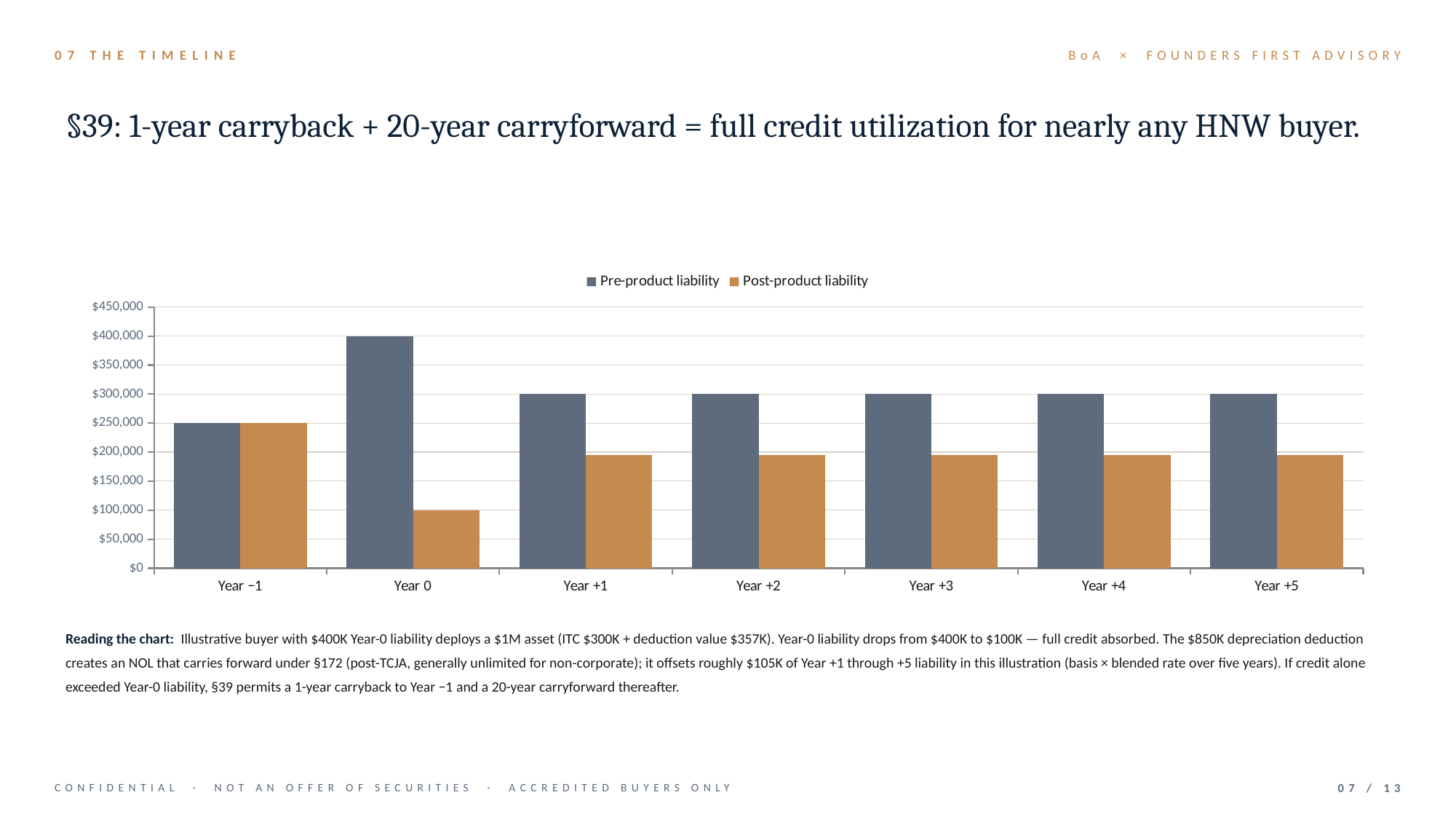
How many year categories are shown on the x axis? 7 What is the difference between Pre-product liability and Post-product liability in Year 0? $300,000 What kind of chart is shown on the slide? bar chart How many series does the legend list? 2 Is the Post-product liability for Year +2 greater or less than $150,000? greater What is the Pre-product liability value for Year 0? $400,000 Which year has the highest Pre-product liability? Year 0 Which is larger: Pre-product liability in Year +1 or Pre-product liability in Year −1? Pre-product liability in Year +1 Which year has the lowest Post-product liability? Year 0 What is the Pre-product liability value for Year −1? $250,000 What is the Pre-product liability value for Year +3? $300,000 What is the Post-product liability value for Year 0? $100,000